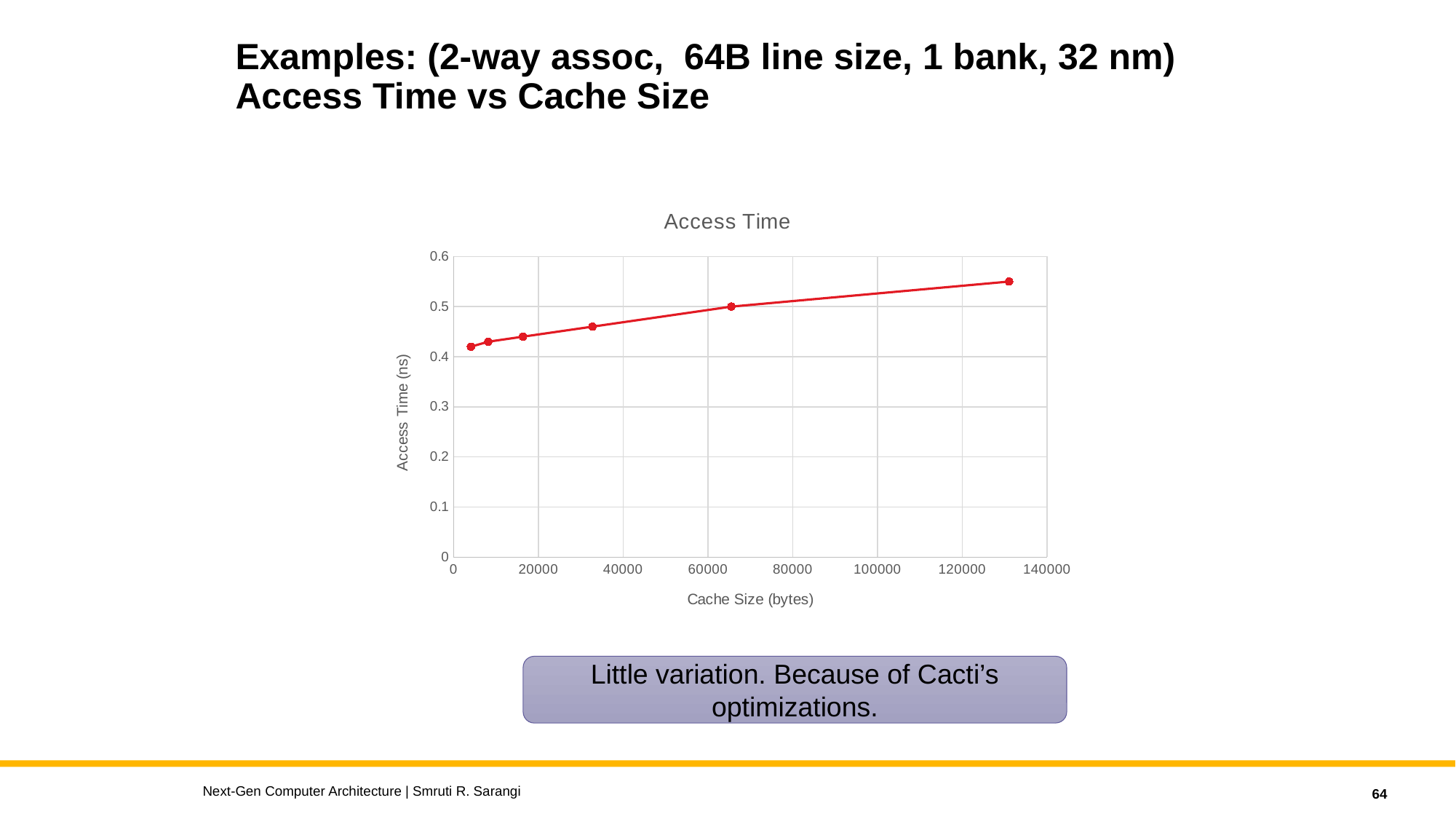
Is the access time for the largest cache size plotted greater or less than 0.5? greater Does the access time rise or fall as cache size increases along the x axis? rises Is the access time for the smallest cache size plotted greater or less than 0.5? less What is the label of the y axis? Access Time (ns) Which plotted point has the lowest access time: the leftmost point or the rightmost point? the leftmost point Which plotted point has the highest access time: the one at the smallest cache size or the one at the largest cache size? the one at the largest cache size Is the access time at the largest cache size larger or smaller than the access time at the smallest cache size? larger Is the access time for the smallest cache size plotted greater or less than 0.4? greater What kind of chart is shown on the slide? line chart What is the title of the chart? Access Time How many data points are plotted on the line? 6